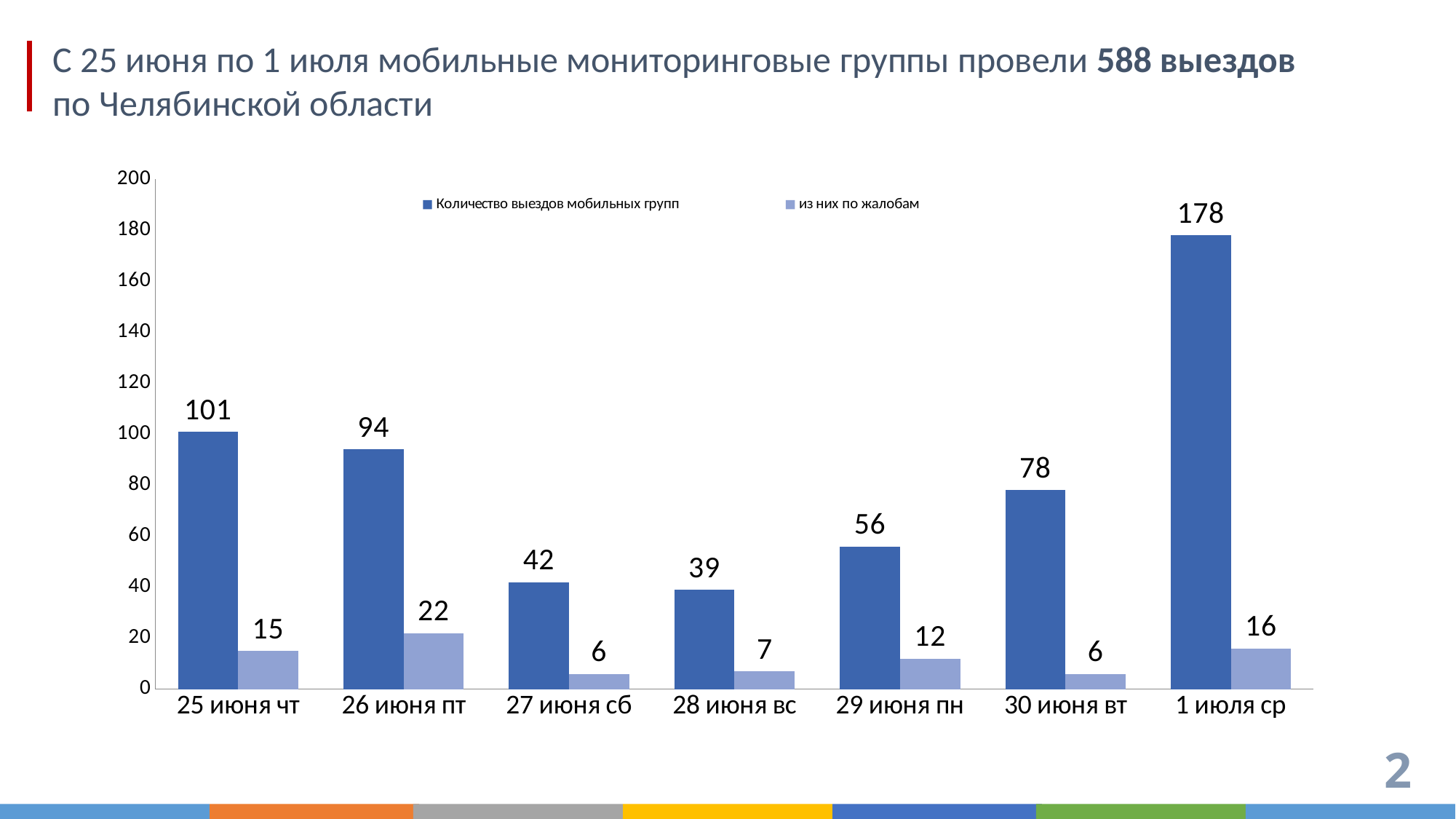
Is the value of "Количество выездов мобильных групп" for 26 июня пт greater or less than 100? less Which day has the highest value for "из них по жалобам"? 26 июня пт What is the value of "Количество выездов мобильных групп" for 28 июня вс? 39 Which day has the lowest value for "Количество выездов мобильных групп"? 28 июня вс What is the value of "из них по жалобам" for 26 июня пт? 22 How many days are shown on the x axis? 7 What is the difference between "Количество выездов мобильных групп" for 1 июля ср and 25 июня чт? 77 How many series does the legend list? 2 What is the value of "Количество выездов мобильных групп" for 1 июля ср? 178 Which is larger: "Количество выездов мобильных групп" for 29 июня пн or for 30 июня вт? 30 июня вт Which day has the highest value for "Количество выездов мобильных групп"? 1 июля ср What kind of chart is shown on the slide? bar chart